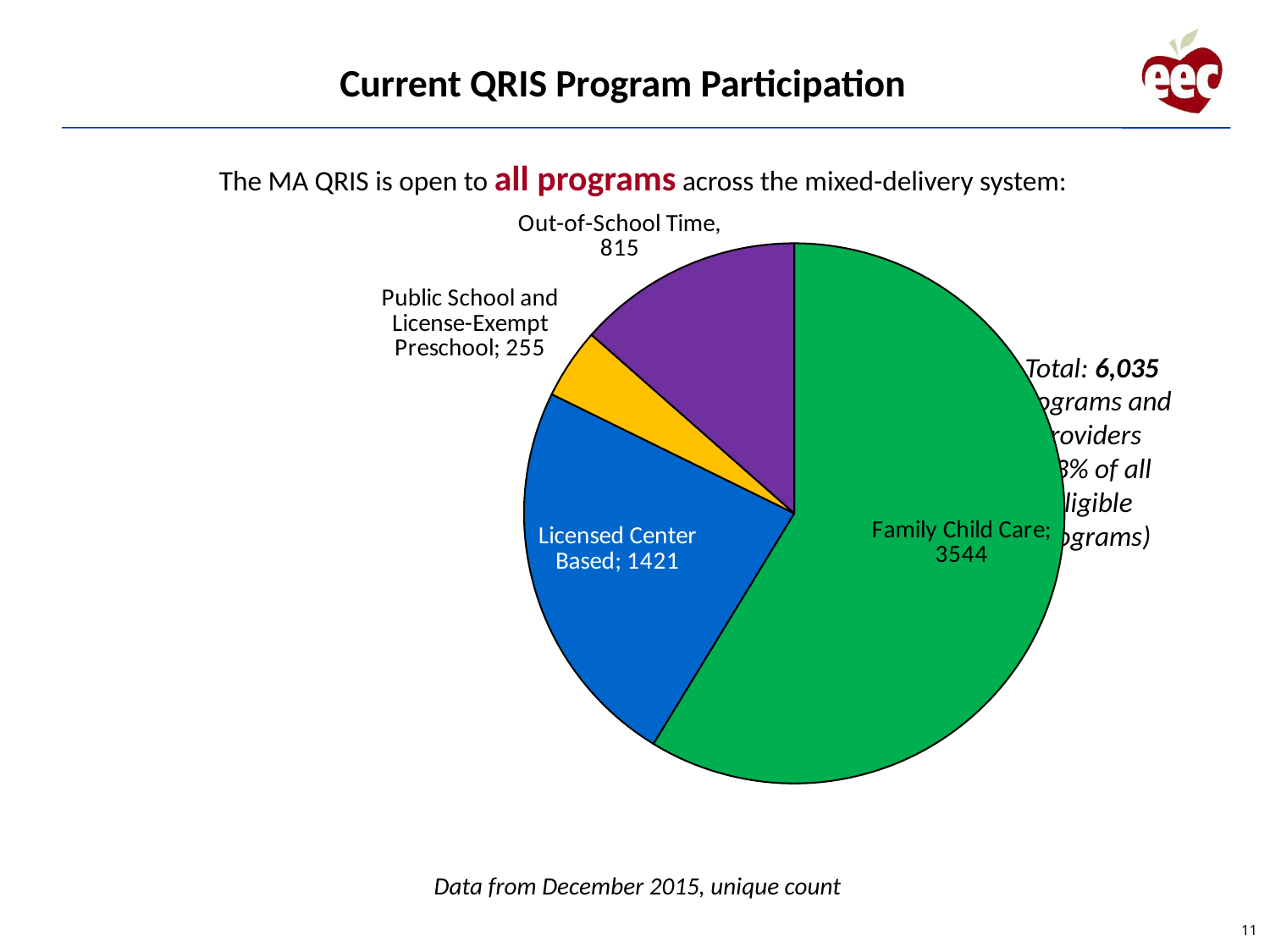
What is the value for Out-of-School Time? 815 What kind of chart is shown on the slide? pie chart Which category has the smallest slice of the pie? Public School and License-Exempt Preschool What is the difference between the Family Child Care value and the Licensed Center Based value? 2123 What is the value for Family Child Care? 3544 Which is larger, Licensed Center Based or Out-of-School Time? Licensed Center Based How many slices does the pie chart have? 4 What is the total number of programs and providers shown on the slide? 6,035 What is the value for Public School and License-Exempt Preschool? 255 Which category has the largest slice of the pie? Family Child Care What is the value for Licensed Center Based? 1421 What colour is the Family Child Care slice? green